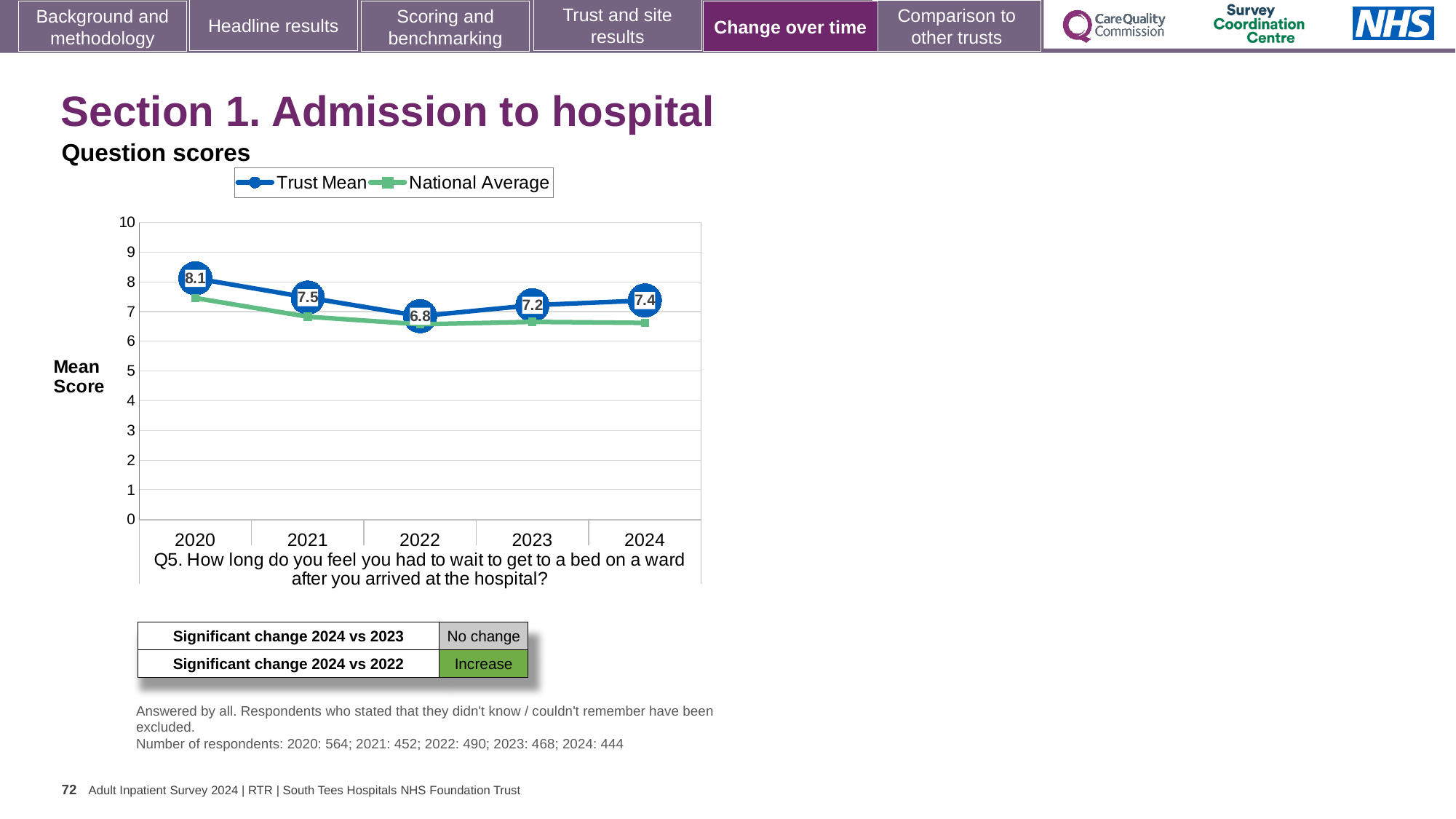
What is the Trust Mean score for 2024? 7.4 What is the difference between the Trust Mean scores for 2020 and 2022? 1.3 In which year is the Trust Mean score highest? 2020 In which year is the Trust Mean score lowest? 2022 How many years are shown on the x axis? 5 Which is larger, the Trust Mean score for 2021 or for 2023? 2021 What is the Trust Mean score for 2020? 8.1 Is the National Average value for 2024 greater or less than 7? less What is the Trust Mean score for 2022? 6.8 How many series does the legend list? 2 What kind of chart is shown on the slide? Line chart Does the Trust Mean score rise or fall from 2020 to 2022? Fall